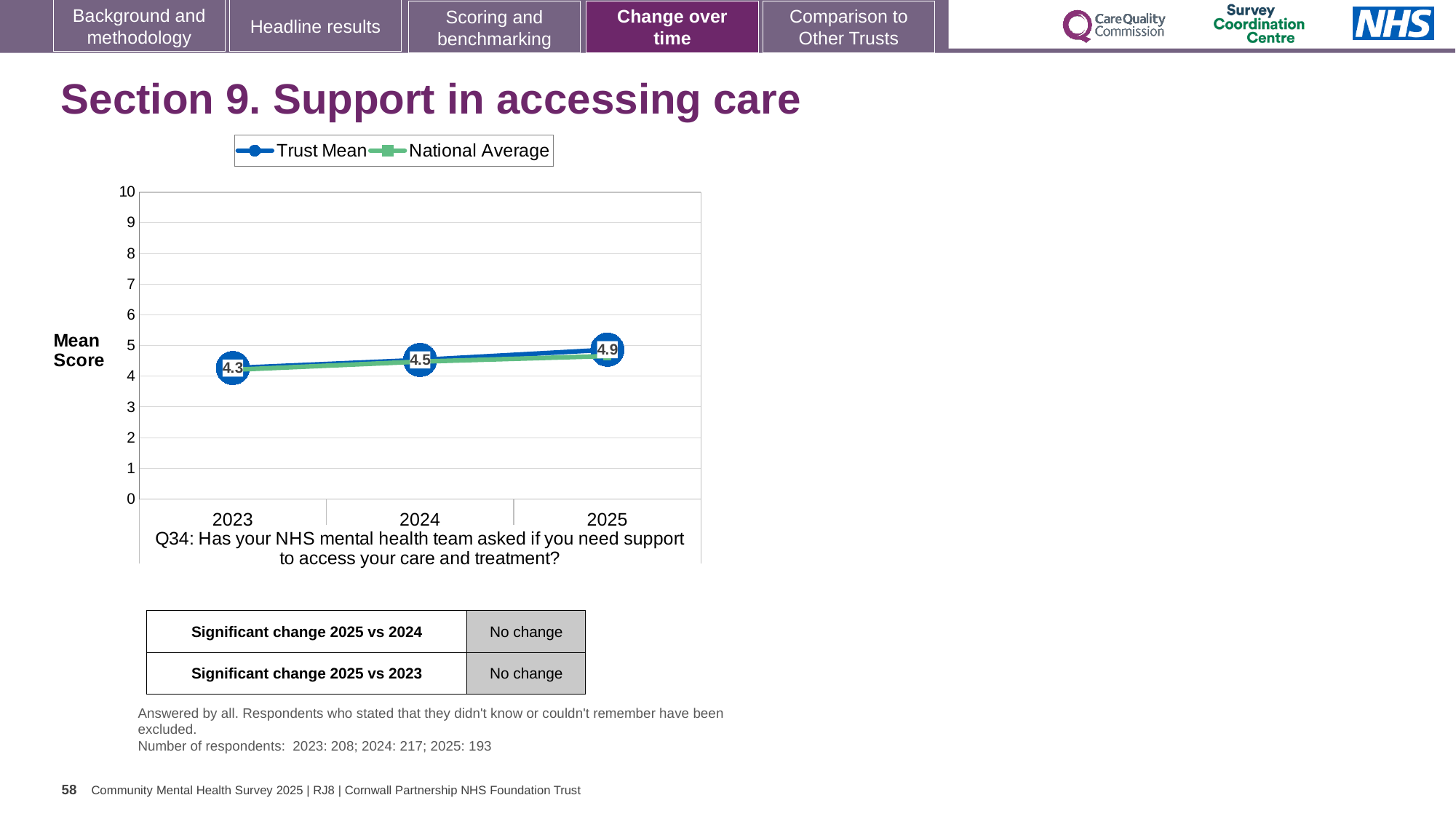
Is the Trust Mean score for 2024 greater or less than 5? less Is the National Average for 2025 greater or less than 4? greater In which year is the Trust Mean score lowest? 2023 In which year is the Trust Mean score highest? 2025 Does the Trust Mean score rise or fall from 2023 to 2025? Rise What is the Trust Mean score for 2025? 4.9 What is the Trust Mean score for 2023? 4.3 What is the difference between the Trust Mean score in 2025 and in 2023? 0.6 How many years are shown on the x axis? 3 What kind of chart is shown? Line chart What is the Trust Mean score for 2024? 4.5 How many series does the legend list? 2